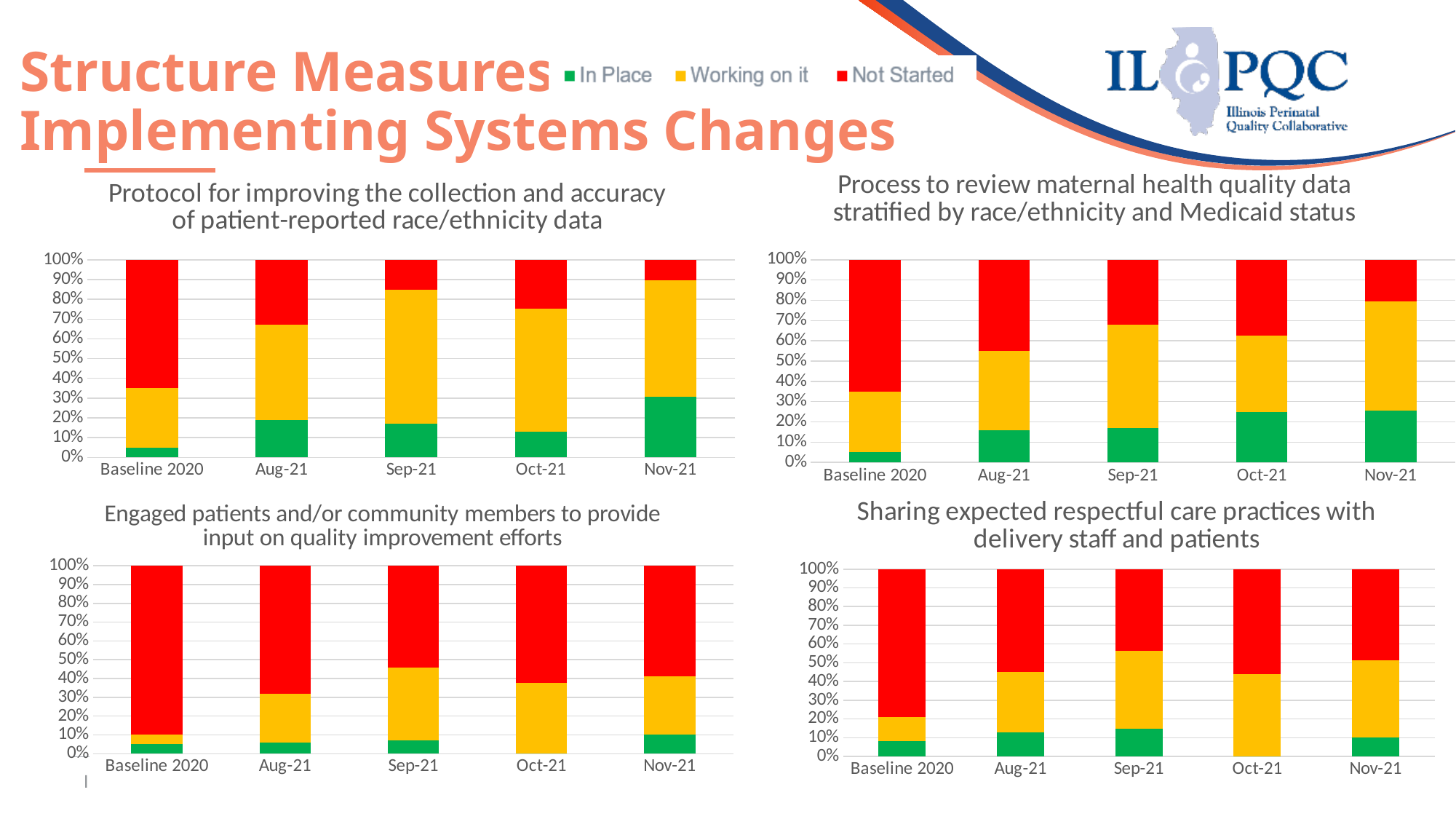
In the 'Engaged patients and/or community members to provide input on quality improvement efforts' chart, which period has the largest Not Started share? Baseline 2020 In the 'Protocol for improving the collection and accuracy of patient-reported race/ethnicity data' chart, is the In Place share for Nov-21 greater or less than 20%? greater What kind of chart is used for 'Protocol for improving the collection and accuracy of patient-reported race/ethnicity data'? Stacked bar chart In the 'Process to review maternal health quality data stratified by race/ethnicity and Medicaid status' chart, is the Not Started share larger for Baseline 2020 or Nov-21? Baseline 2020 According to the legend, which colour represents 'Not Started'? Red In the 'Protocol for improving the collection and accuracy of patient-reported race/ethnicity data' chart, which period has the largest In Place share? Nov-21 In the 'Protocol for improving the collection and accuracy of patient-reported race/ethnicity data' chart, is the Not Started share for Baseline 2020 greater or less than 50%? greater In the 'Sharing expected respectful care practices with delivery staff and patients' chart, is the Not Started share for Baseline 2020 greater or less than 70%? greater In the 'Process to review maternal health quality data stratified by race/ethnicity and Medicaid status' chart, does the In Place share rise or fall from Baseline 2020 to Nov-21? rises How many series does the legend at the top of the slide list? 3 In the 'Protocol for improving the collection and accuracy of patient-reported race/ethnicity data' chart, how many time periods are shown on the x axis? 5